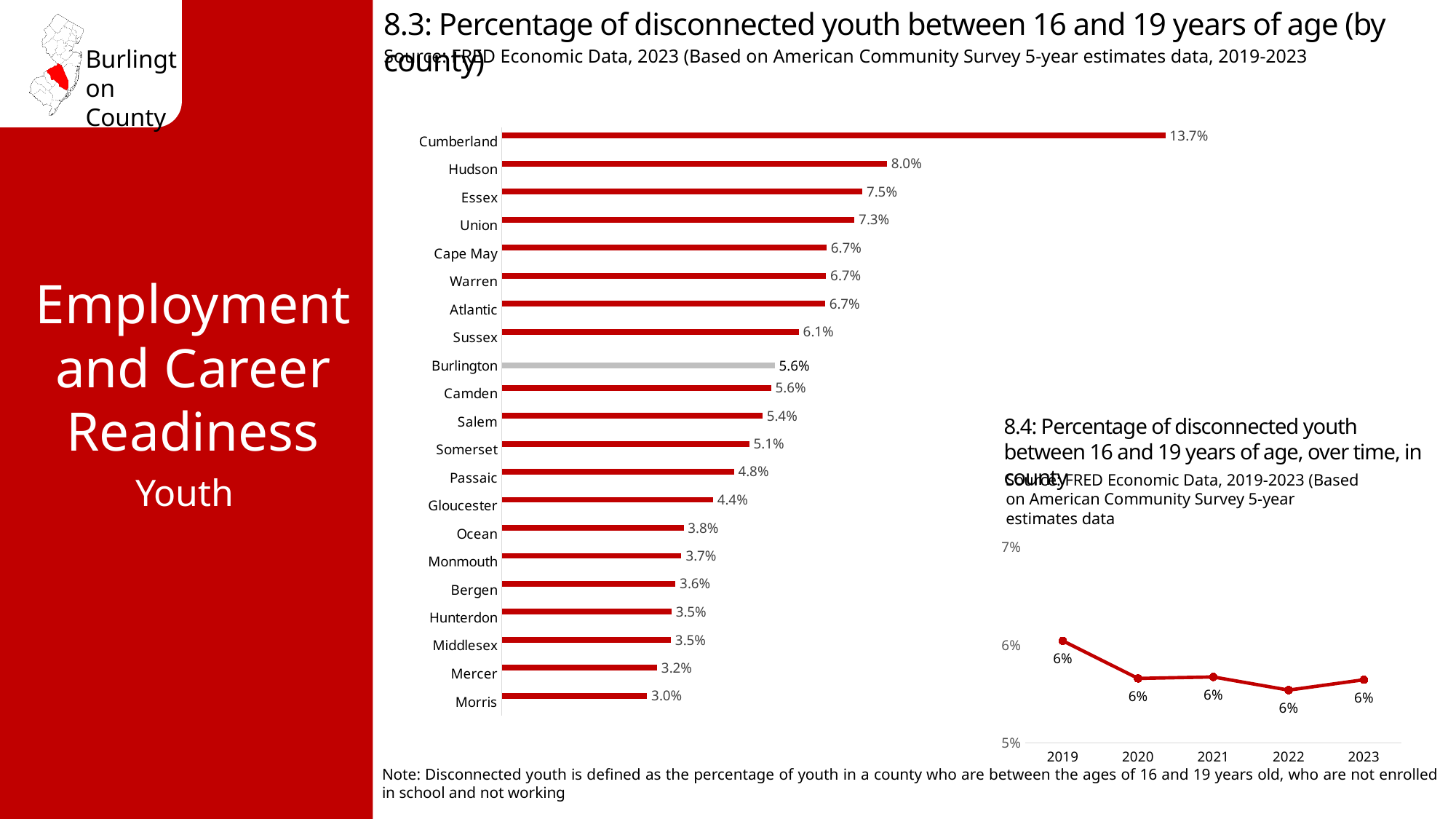
In chart 8.4 (percentage of disconnected youth over time), how many years are plotted? 5 In chart 8.4 (percentage of disconnected youth over time), what is the labelled value for 2019? 6% In chart 8.3 (percentage of disconnected youth by county), what is the difference between the values for Cumberland and Hudson? 5.7% In chart 8.3 (percentage of disconnected youth by county), what is the value for Hudson? 8.0% In chart 8.3 (percentage of disconnected youth by county), which has the larger value, Essex or Union? Essex In chart 8.3 (percentage of disconnected youth by county), which county's bar is coloured grey instead of red? Burlington In chart 8.3 (percentage of disconnected youth by county), which county has the lowest percentage? Morris In chart 8.3 (percentage of disconnected youth by county), which county has the highest percentage? Cumberland In chart 8.3 (percentage of disconnected youth by county), what is the value for Burlington? 5.6% In chart 8.3 (percentage of disconnected youth by county), what kind of chart is used? bar chart In chart 8.4 (percentage of disconnected youth over time), what kind of chart is used? line chart In chart 8.3 (percentage of disconnected youth by county), how many counties are shown? 21